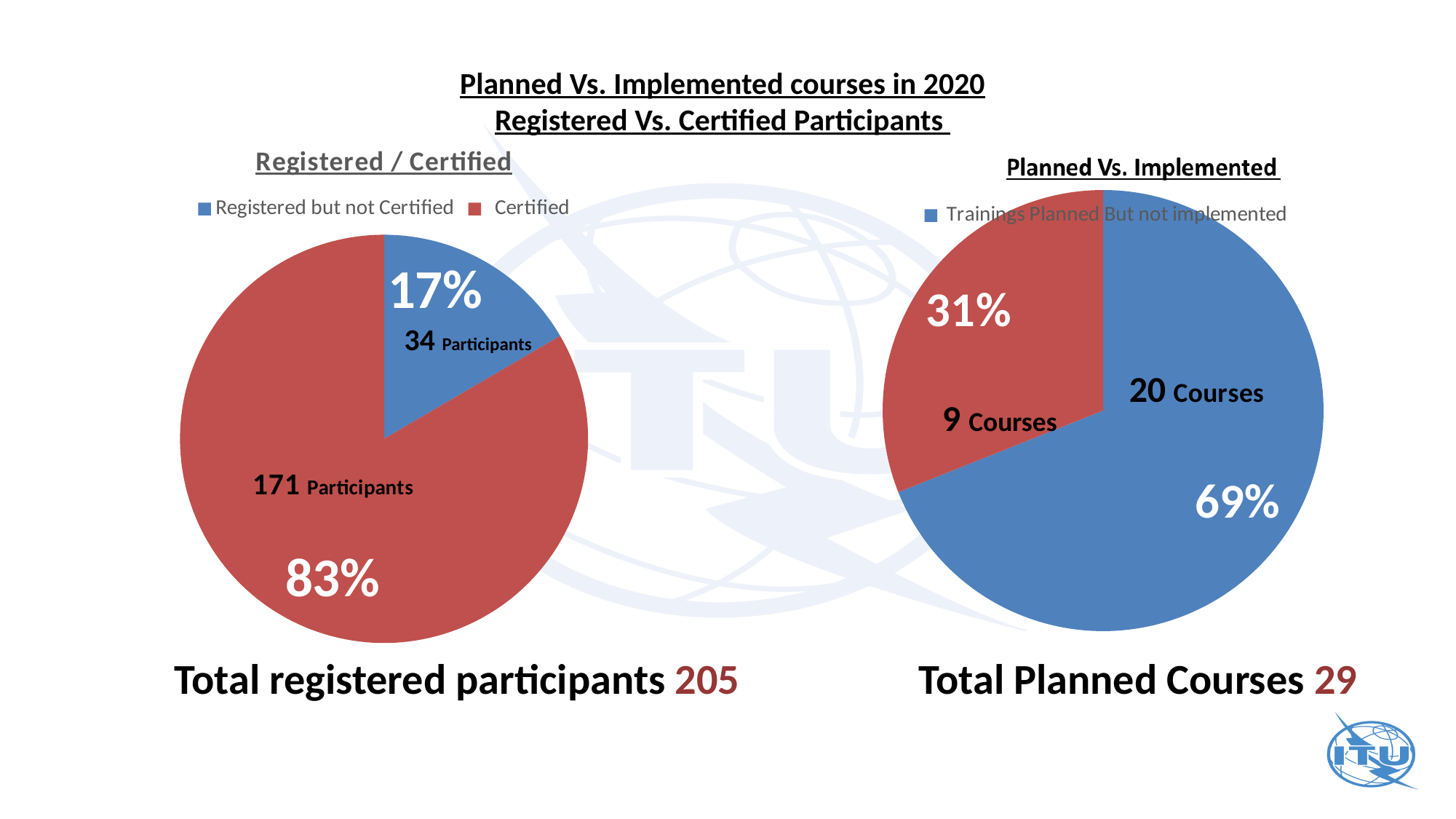
In the 'Registered / Certified' chart, what percentage of participants are Registered but not Certified? 17% What colour is the 'Certified' slice in the 'Registered / Certified' chart? Red In the 'Planned Vs. Implemented' chart, what percentage does the 'Trainings Planned But not implemented' slice represent? 69% In the 'Registered / Certified' chart, which slice is larger: Certified or Registered but not Certified? Certified How many series does the legend of the 'Registered / Certified' chart list? 2 In the 'Planned Vs. Implemented' chart, how many courses are in the 'Trainings Planned But not implemented' slice? 20 Courses In the 'Registered / Certified' chart, how many participants are Certified? 171 Participants In the 'Planned Vs. Implemented' chart, what percentage does the red slice with 9 Courses represent? 31% In the 'Registered / Certified' chart, what is the difference between the number of Certified participants and the number Registered but not Certified? 137 In the 'Registered / Certified' chart, how many participants are Registered but not Certified? 34 Participants What kind of chart is the 'Registered / Certified' chart? Pie chart What total is stated below the 'Planned Vs. Implemented' chart for planned courses? 29